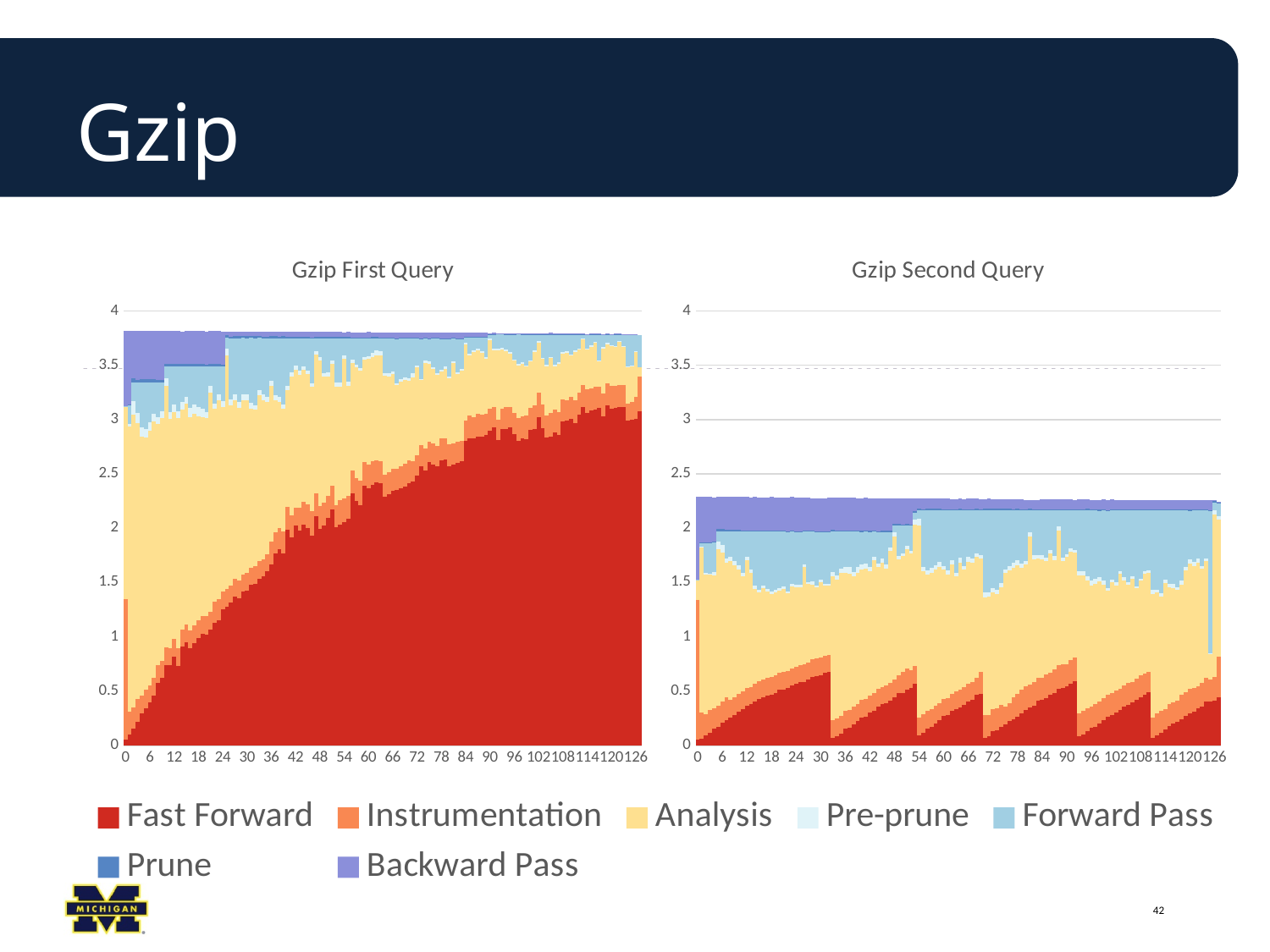
Which chart has the larger total stacked value at x = 126, Gzip First Query or Gzip Second Query? Gzip First Query What kind of chart is the Gzip First Query chart? Stacked bar chart What is the title of the chart on the right side of the slide? Gzip Second Query In the Gzip Second Query chart, is the total stacked value at x = 60 greater or less than 2? greater In the Gzip First Query chart, is the Fast Forward value at x = 6 greater or less than 1? less How many series does the legend list for the charts on this slide? 7 What is the highest value shown on the y axis of the Gzip Second Query chart? 4 In the Gzip First Query chart, is the Fast Forward value at x = 120 greater or less than 2.5? greater What is the title of the chart on the left side of the slide? Gzip First Query In the Gzip First Query chart, does the Fast Forward series rise or fall as the x axis increases from 0 to 126? Rise